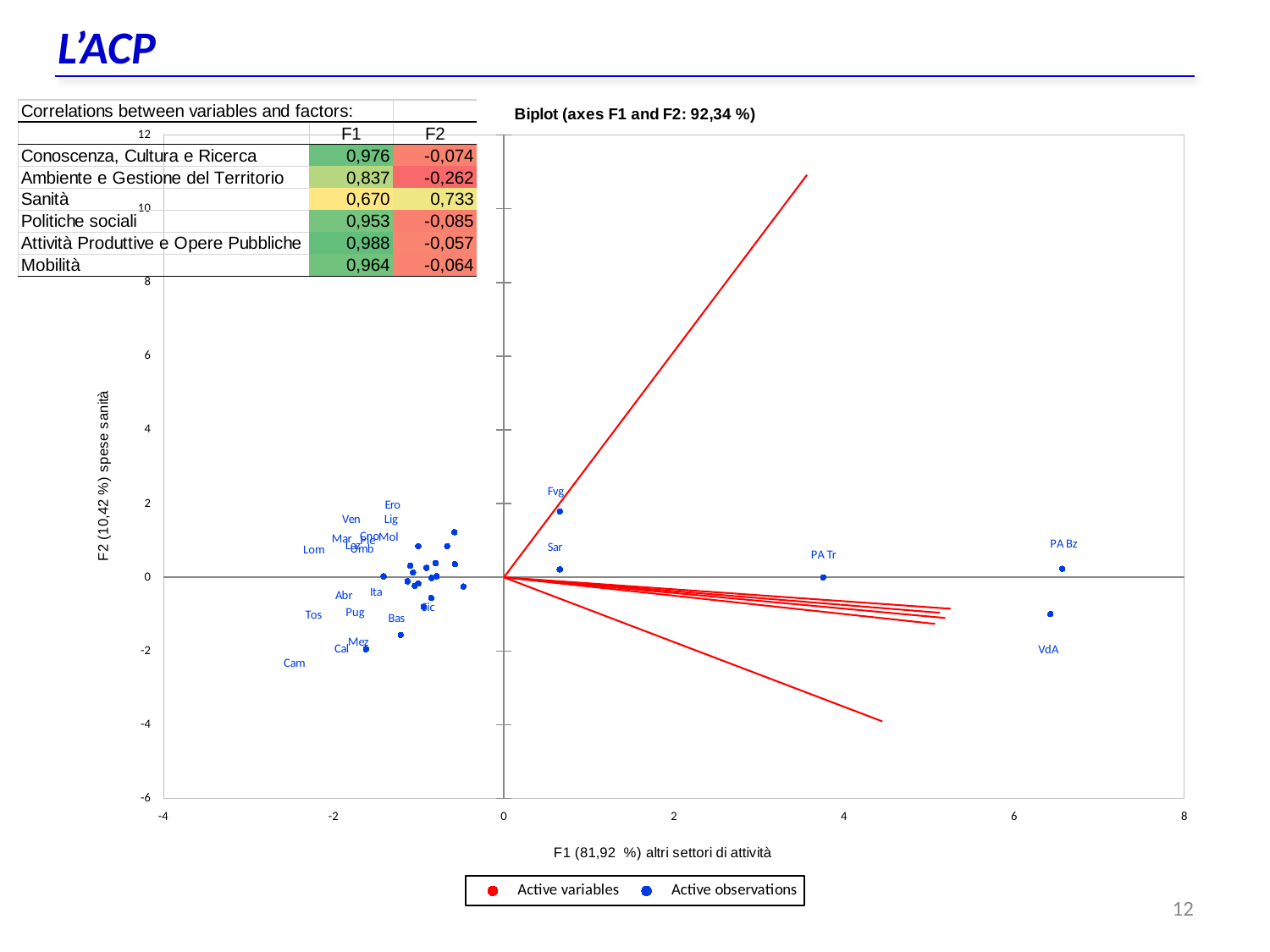
What is the label of the horizontal axis of the biplot? F1 (81,92 %) altri settori di attività Which observation has the highest F2 value on the biplot? Fvg What type of chart is shown on the slide? scatter chart (biplot) How many red active-variable vectors are drawn on the biplot? 6 Is the F1 value for PA Bz greater or less than 6? greater How many series does the chart legend list? 2 Is the F1 value for PA Tr greater or less than 4? less Which has the larger F1 value, PA Bz or Cam? PA Bz Is the F2 value for Fvg greater or less than 0? greater What is the title of the chart? Biplot (axes F1 and F2: 92,34 %)